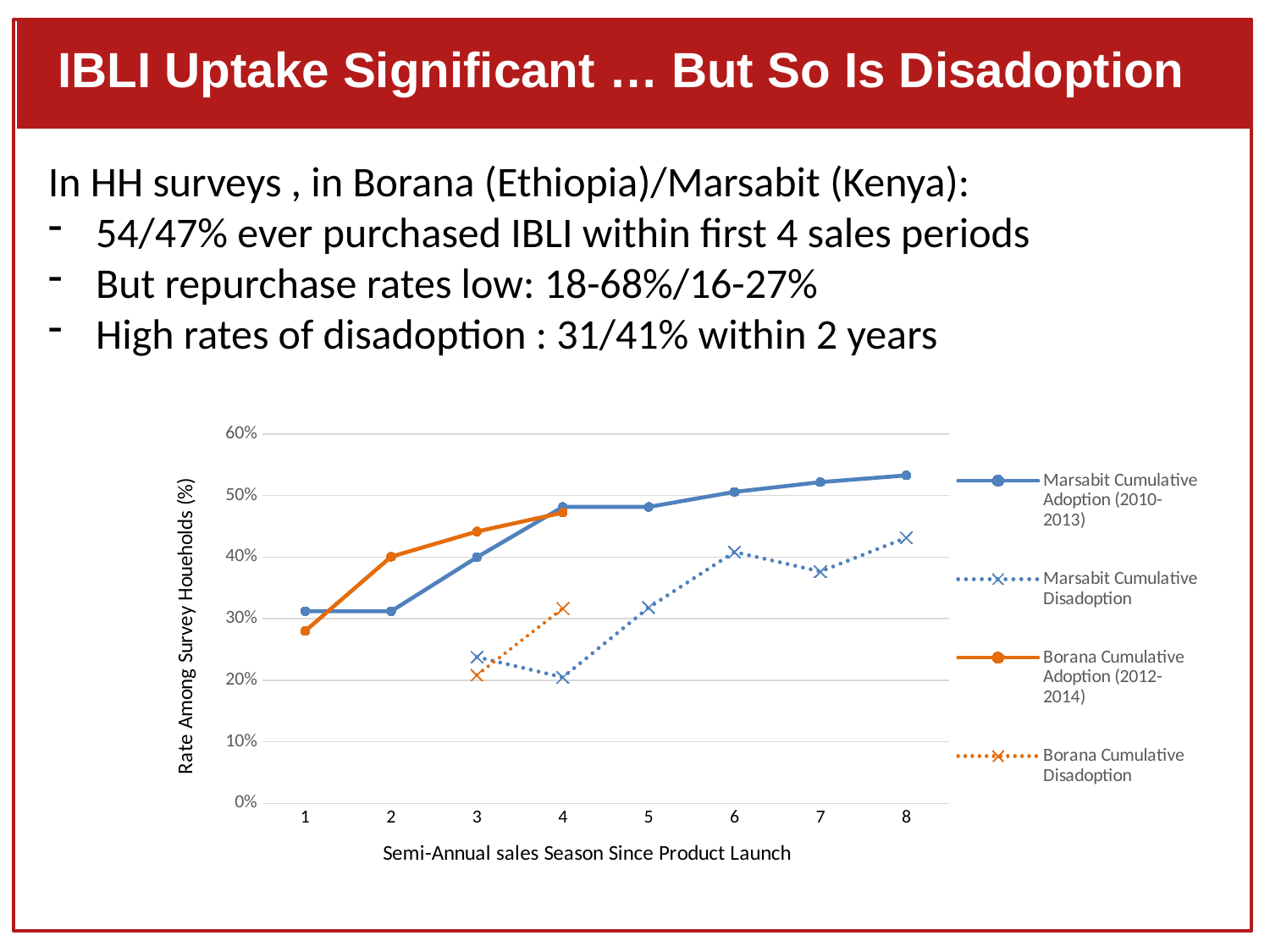
What kind of chart is shown on the slide? Line chart At which season does the Marsabit Cumulative Adoption (2010-2013) series reach its highest value? 8 Is the Marsabit Cumulative Adoption (2010-2013) value at season 8 greater or less than 50%? greater At season 2, which is higher: Borana Cumulative Adoption (2012-2014) or Marsabit Cumulative Adoption (2010-2013)? Borana Cumulative Adoption (2012-2014) Is the Marsabit Cumulative Disadoption value at season 4 greater or less than 30%? less Is the Marsabit Cumulative Disadoption value at season 6 greater or less than 30%? greater Does the Marsabit Cumulative Adoption (2010-2013) series rise or fall from season 1 to season 8? Rise How many series does the chart legend list? 4 What is the title of the chart's y axis? Rate Among Survey Households (%) At which season is the Marsabit Cumulative Disadoption series at its lowest value? 4 How many semi-annual sales seasons are shown on the x axis of the chart? 8